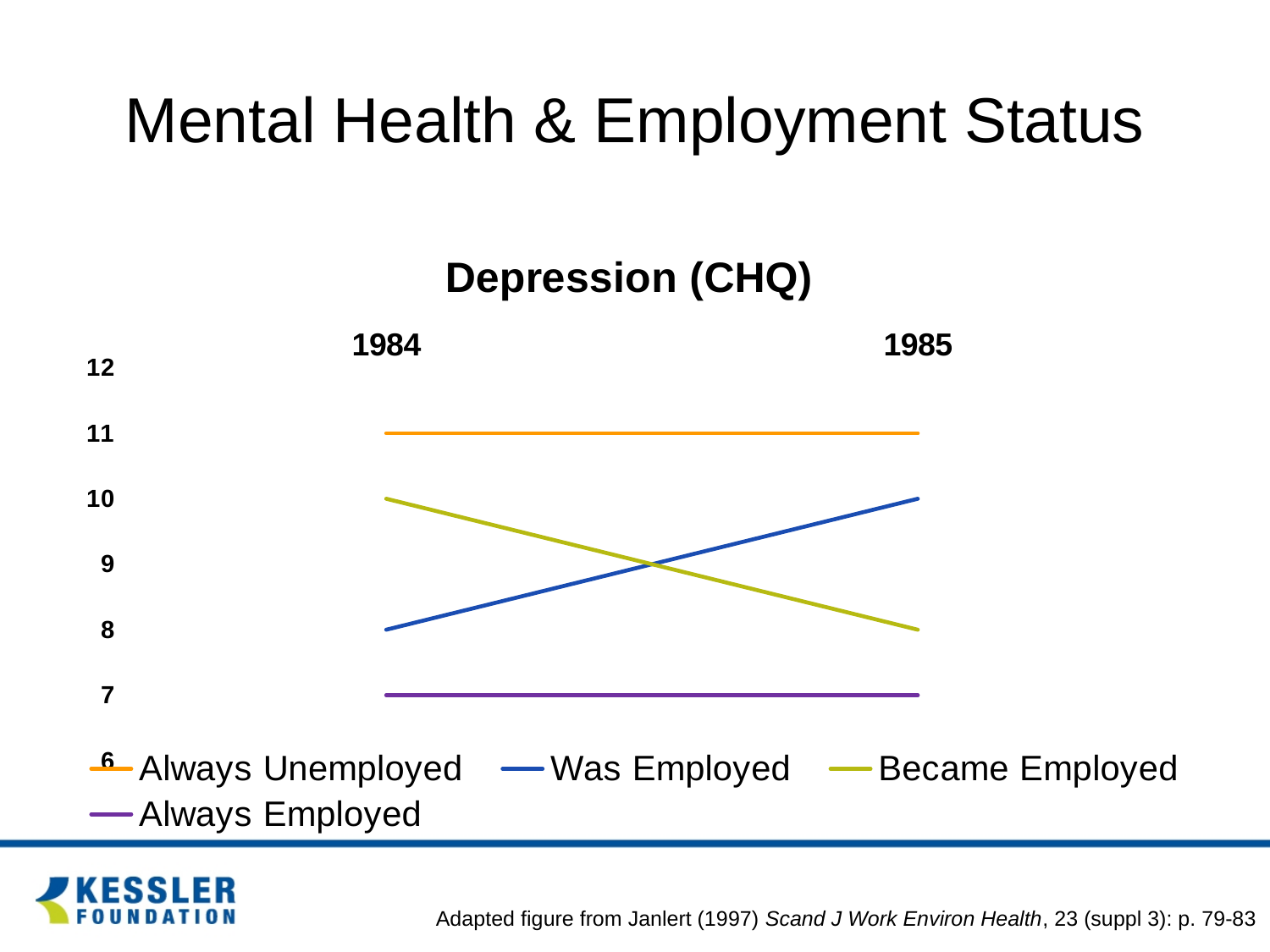
What is the value for Became Employed in 1984? 10 Which series has the lowest value in 1984? Always Employed What is the value for Always Unemployed in 1984? 11 What is the value for Was Employed in 1985? 10 What is the title of the chart? Depression (CHQ) Which series has the highest value in 1985? Always Unemployed How many series does the legend list? 4 What is the difference between the Was Employed values in 1985 and 1984? 2 What is the value for Always Employed in 1985? 7 Does the value for Became Employed rise or fall from 1984 to 1985? fall What kind of chart is shown on the slide? line chart How many years are shown on the x axis? 2